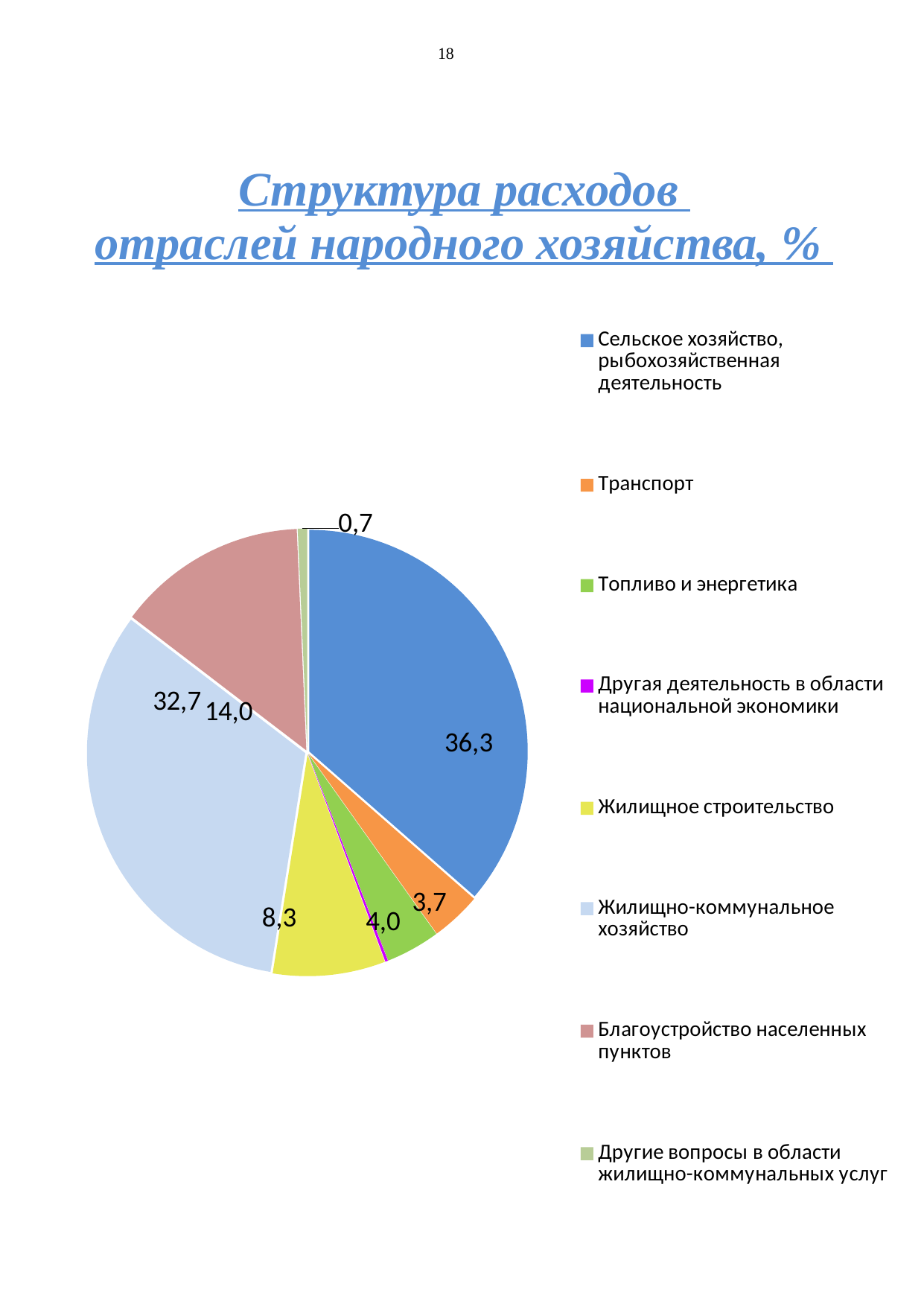
Which is larger, the value for Транспорт or the value for Топливо и энергетика? Топливо и энергетика Which category has the largest slice of the pie? Сельское хозяйство, рыбохозяйственная деятельность What is the value for Жилищное строительство? 8,3 What colour is the slice for Транспорт? Orange What is the value for Жилищно-коммунальное хозяйство? 32,7 What kind of chart is shown on the slide? Pie chart How many categories does the legend list? 8 What is the value for Благоустройство населенных пунктов? 14,0 What is the difference between the values for Благоустройство населенных пунктов and Жилищное строительство? 5,7 What is the value for Другие вопросы в области жилищно-коммунальных услуг? 0,7 What is the difference between the values for Сельское хозяйство, рыбохозяйственная деятельность and Жилищно-коммунальное хозяйство? 3,6 What is the value for Сельское хозяйство, рыбохозяйственная деятельность? 36,3